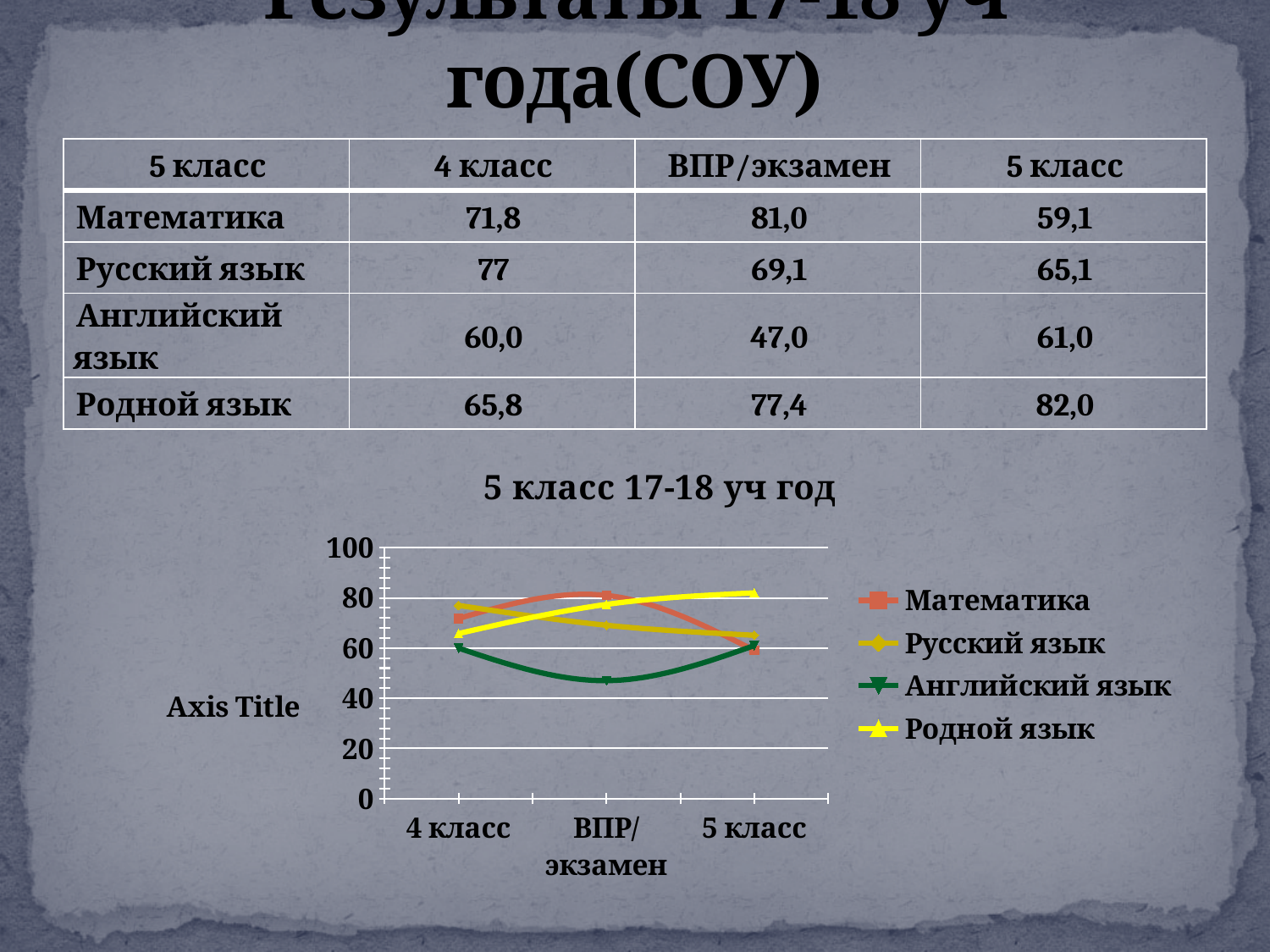
In the chart "5 класс 17-18 уч год", which series has the lowest value at "4 класс"? Английский язык In the chart "5 класс 17-18 уч год", does the "Родной язык" line rise or fall from "4 класс" to "5 класс"? rise In the chart "5 класс 17-18 уч год", which series has the highest value at "5 класс"? Родной язык In the chart "5 класс 17-18 уч год", is the value of "Родной язык" at "5 класс" greater or less than 60? greater In the chart "5 класс 17-18 уч год", is the value of "Английский язык" at "ВПР/экзамен" greater or less than 60? less What is the title of the line chart on the slide? 5 класс 17-18 уч год How many categories are on the x axis of the chart "5 класс 17-18 уч год"? 3 In the chart "5 класс 17-18 уч год", which series has the lowest value at "ВПР/экзамен"? Английский язык How many series does the legend of the chart "5 класс 17-18 уч год" list? 4 In the chart "5 класс 17-18 уч год", does the "Русский язык" line rise or fall from "4 класс" to "5 класс"? fall What kind of chart is shown under the title "5 класс 17-18 уч год"? line chart In the chart "5 класс 17-18 уч год", which is larger at "4 класс": "Русский язык" or "Математика"? Русский язык